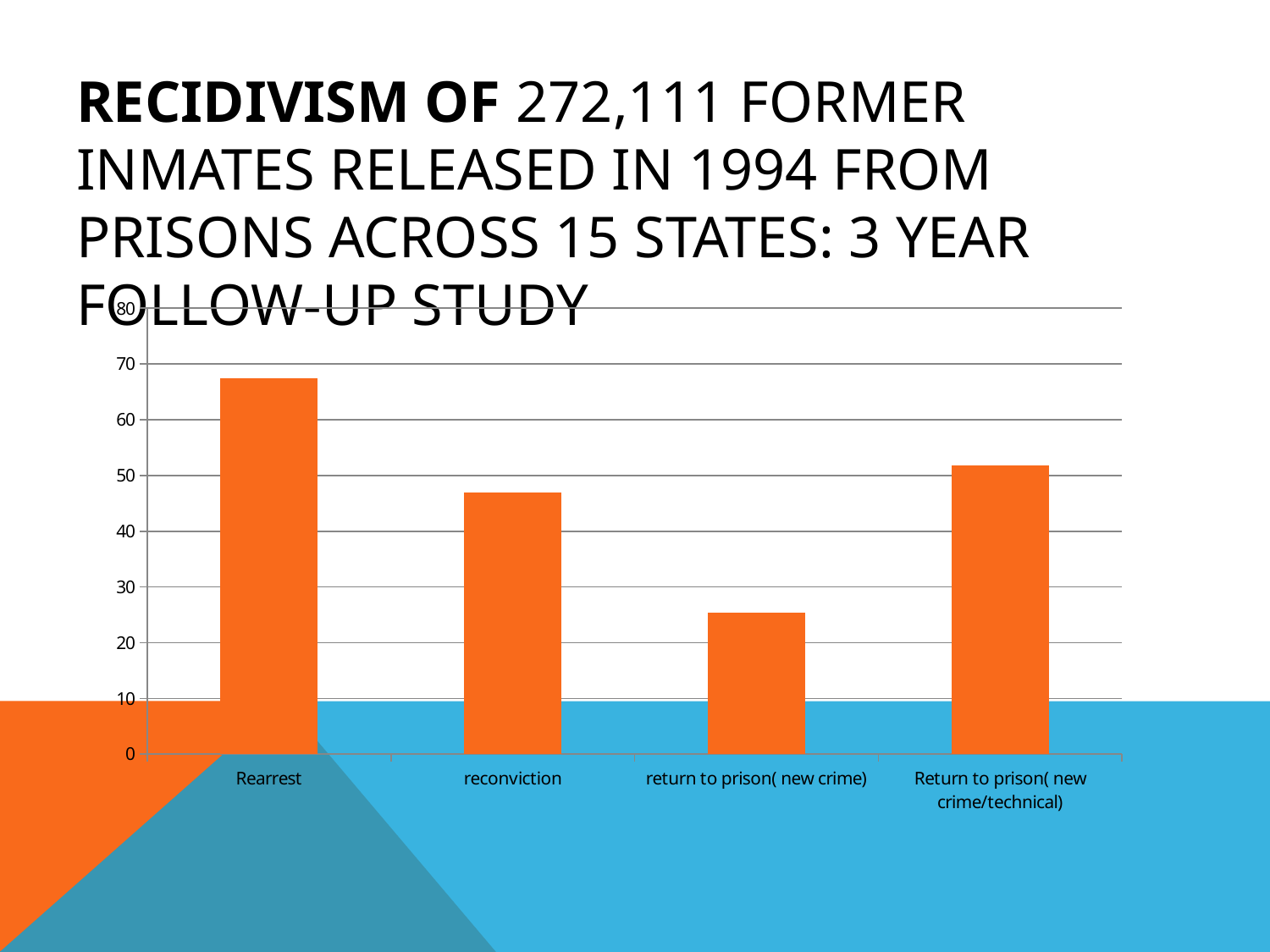
Is the value for Return to prison( new crime/technical) greater or less than 40? greater Is the value for reconviction greater or less than 50? less What kind of chart is shown on the slide? bar chart Which category has the highest bar in the chart? Rearrest Which category has the lowest bar in the chart? return to prison( new crime) What is the highest value shown on the y axis of the chart? 80 Is the value for return to prison( new crime) greater or less than 30? less Which is larger: the value for reconviction or the value for Return to prison( new crime/technical)? Return to prison( new crime/technical) Which is larger: the value for Rearrest or the value for reconviction? Rearrest How many categories are plotted on the x axis of the chart? 4 What colour are the bars in the chart? orange